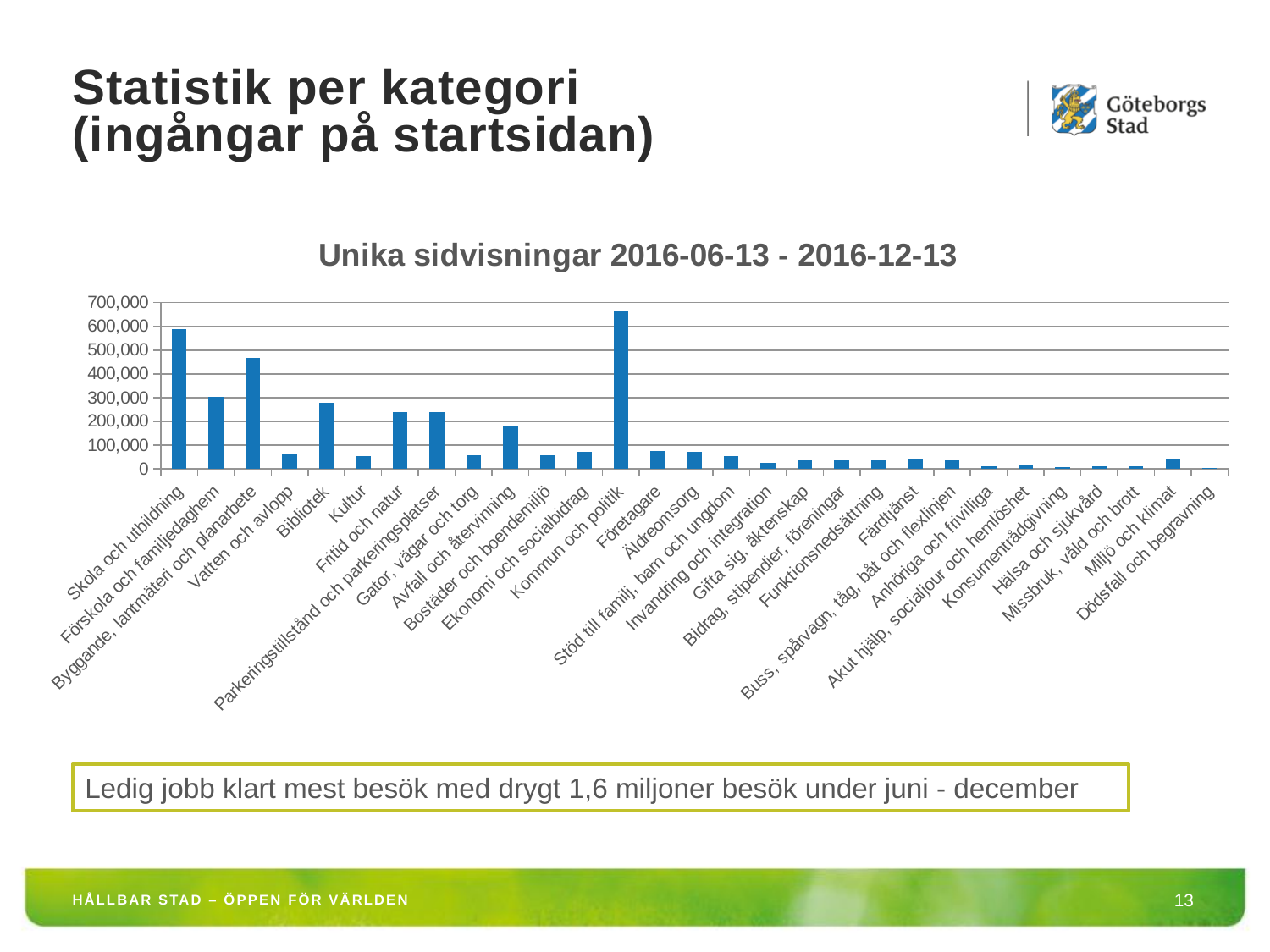
Is the value for Byggande, lantmäteri och planarbete greater or less than 400,000? greater Is the value for Vatten och avlopp greater or less than 100,000? less Which category has the highest number of unique page views? Kommun och politik Which has more unique page views, Kommun och politik or Skola och utbildning? Kommun och politik Which has more unique page views, Bibliotek or Kultur? Bibliotek How many categories are shown on the x axis of the chart? 29 Is the value for Kommun och politik greater or less than 600,000? greater What is the title of the chart? Unika sidvisningar 2016-06-13 - 2016-12-13 Which has more unique page views, Skola och utbildning or Förskola och familjedaghem? Skola och utbildning What kind of chart is shown on the slide? bar chart